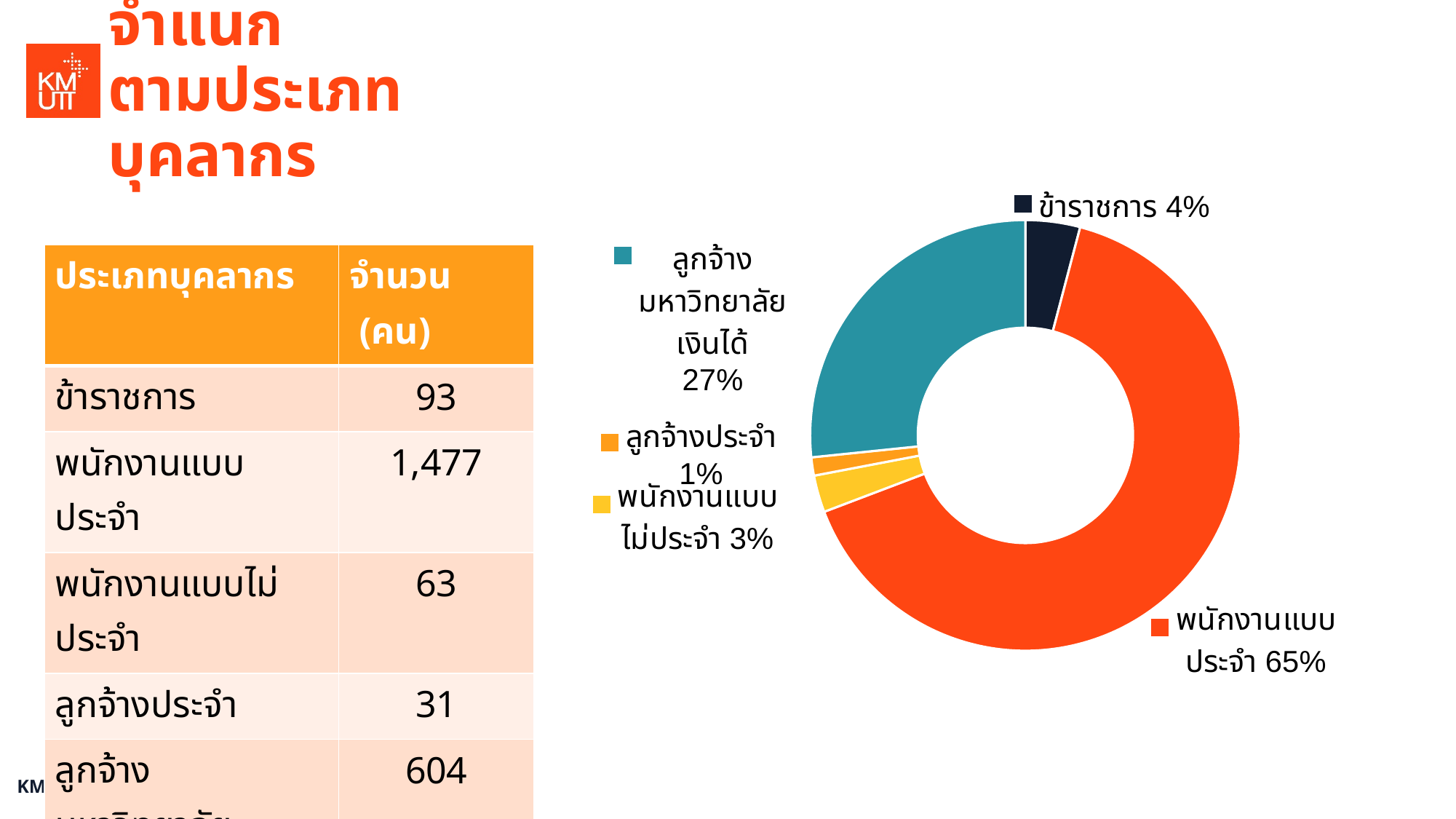
What percentage does the chart show for พนักงานแบบไม่ประจำ? 3% What percentage does the chart show for ลูกจ้างมหาวิทยาลัยเงินได้? 27% Which category has the smallest share of the chart? ลูกจ้างประจำ What colour is the slice for ลูกจ้างมหาวิทยาลัยเงินได้? Teal How many categories are shown in the chart? 5 What is the difference in percentage points between พนักงานแบบประจำ and ลูกจ้างมหาวิทยาลัยเงินได้? 38 What percentage does the chart show for ข้าราชการ? 4% Which has a larger share, ข้าราชการ or พนักงานแบบไม่ประจำ? ข้าราชการ What percentage does the chart show for ลูกจ้างประจำ? 1% Which category has the largest share of the chart? พนักงานแบบประจำ What percentage does the chart show for พนักงานแบบประจำ? 65% What kind of chart is shown on the slide? Doughnut (pie) chart